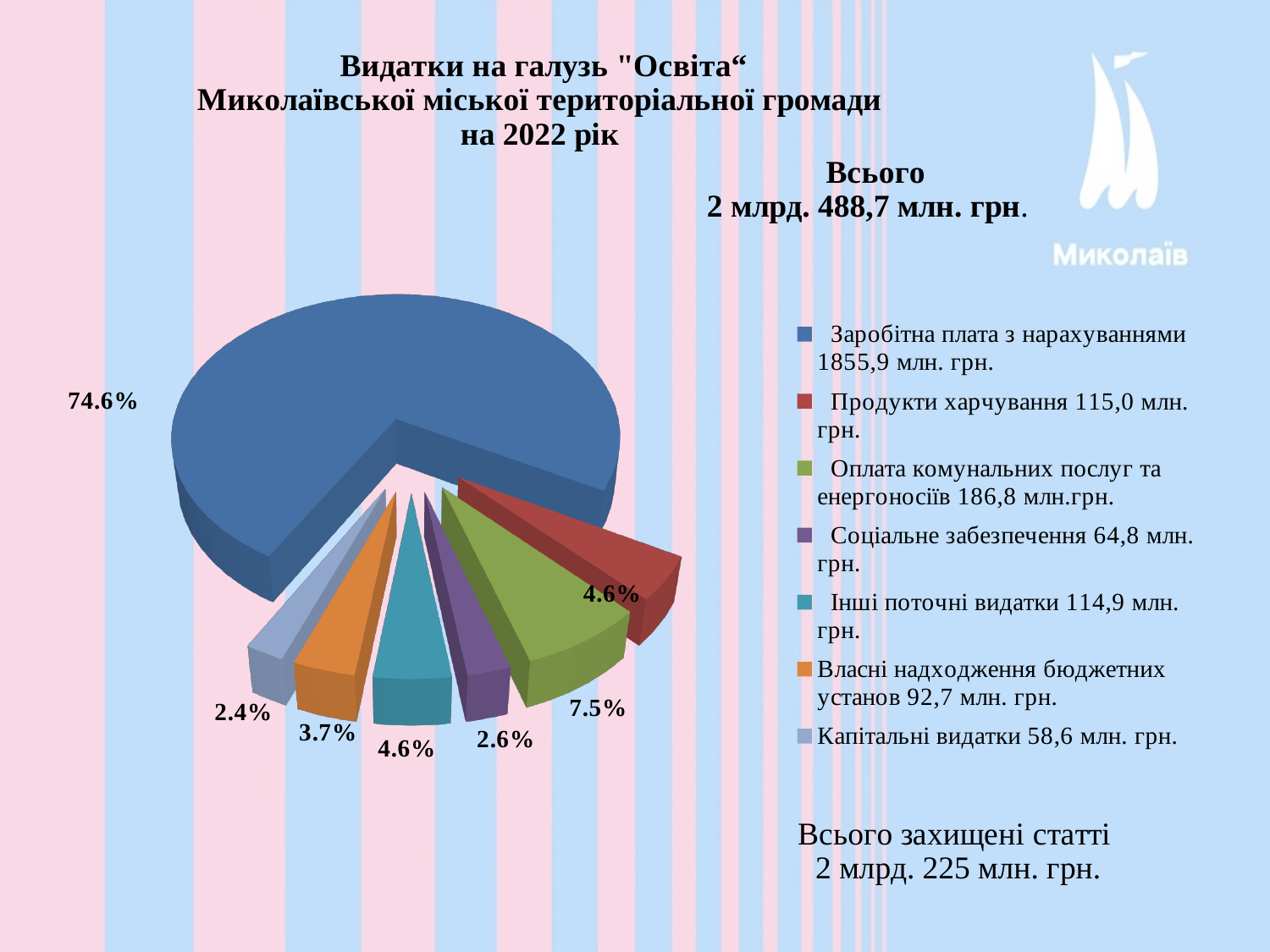
Which is larger: the share for "Власні надходження бюджетних установ" or for "Соціальне забезпечення"? Власні надходження бюджетних установ What share of the pie does "Заробітна плата з нарахуваннями" take? 74.6% Which category has the largest slice of the pie? Заробітна плата з нарахуваннями How many slices does the pie chart have? 7 According to the legend, what amount is given for "Продукти харчування"? 115,0 млн. грн. Which category has the smallest slice of the pie? Капітальні видатки What total amount ("Всього") is stated above the chart? 2 млрд. 488,7 млн. грн. What colour is the largest slice of the pie? Blue What is the difference in percentage points between the "Заробітна плата з нарахуваннями" slice and the "Оплата комунальних послуг та енергоносіїв" slice? 67.1 percentage points What percentage is shown for "Оплата комунальних послуг та енергоносіїв"? 7.5% What kind of chart is shown on the slide? Pie chart What percentage is shown for "Капітальні видатки"? 2.4%